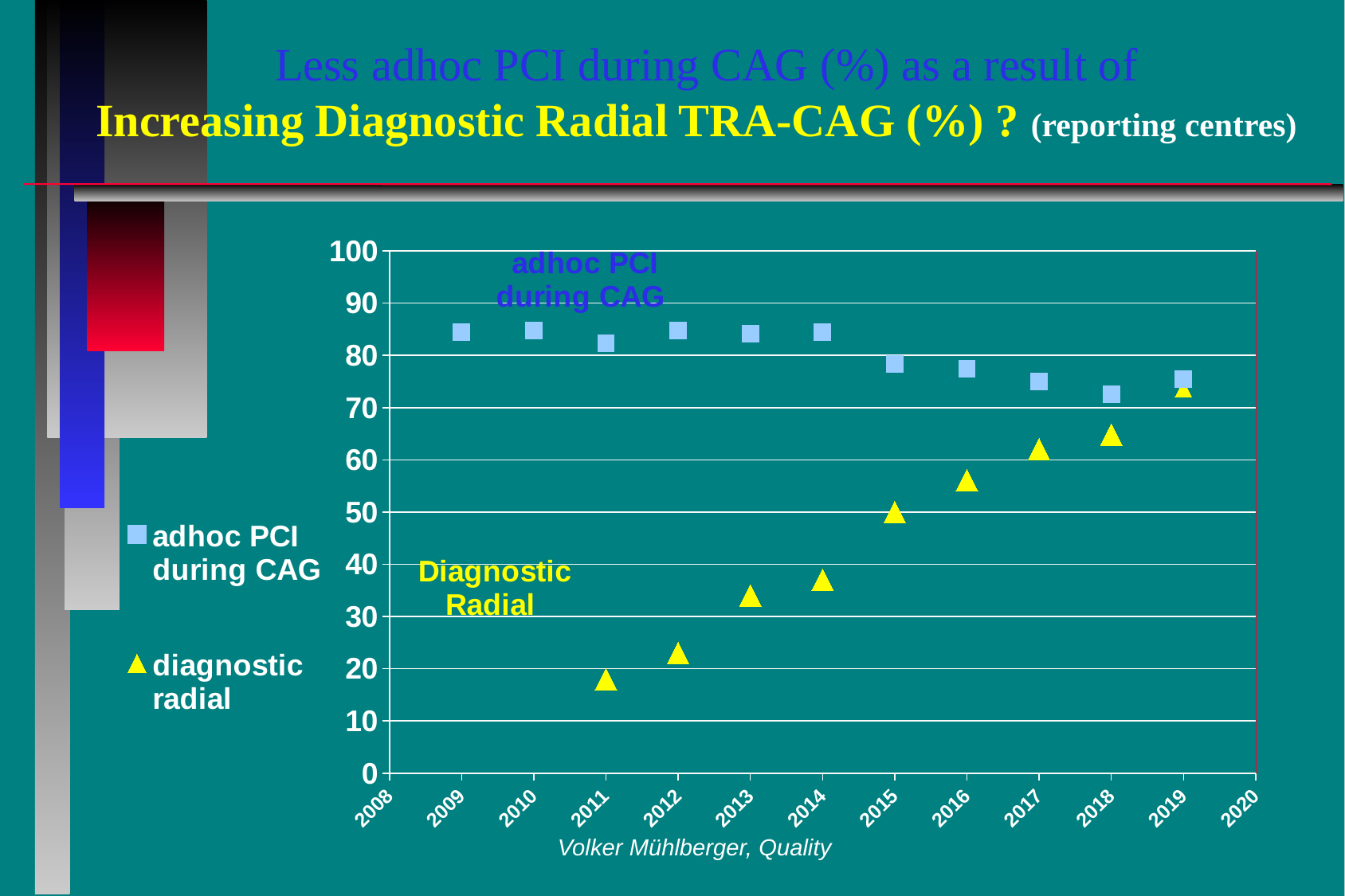
What kind of chart is shown on the slide? scatter chart Is the value for diagnostic radial in 2016 greater or less than 50? greater Is the value for adhoc PCI during CAG in 2009 greater or less than 80? greater Do the values for adhoc PCI during CAG rise or fall from 2009 to 2019? fall Do the values for diagnostic radial rise or fall from 2011 to 2019? rise In 2011, which series has the larger value, adhoc PCI during CAG or diagnostic radial? adhoc PCI during CAG How many data points are plotted for the diagnostic radial series? 9 How many series does the legend list? 2 Is the value for adhoc PCI during CAG in 2015 greater or less than 80? less In which year is the diagnostic radial value lowest? 2011 Which marker shape is used for the diagnostic radial series? yellow triangle